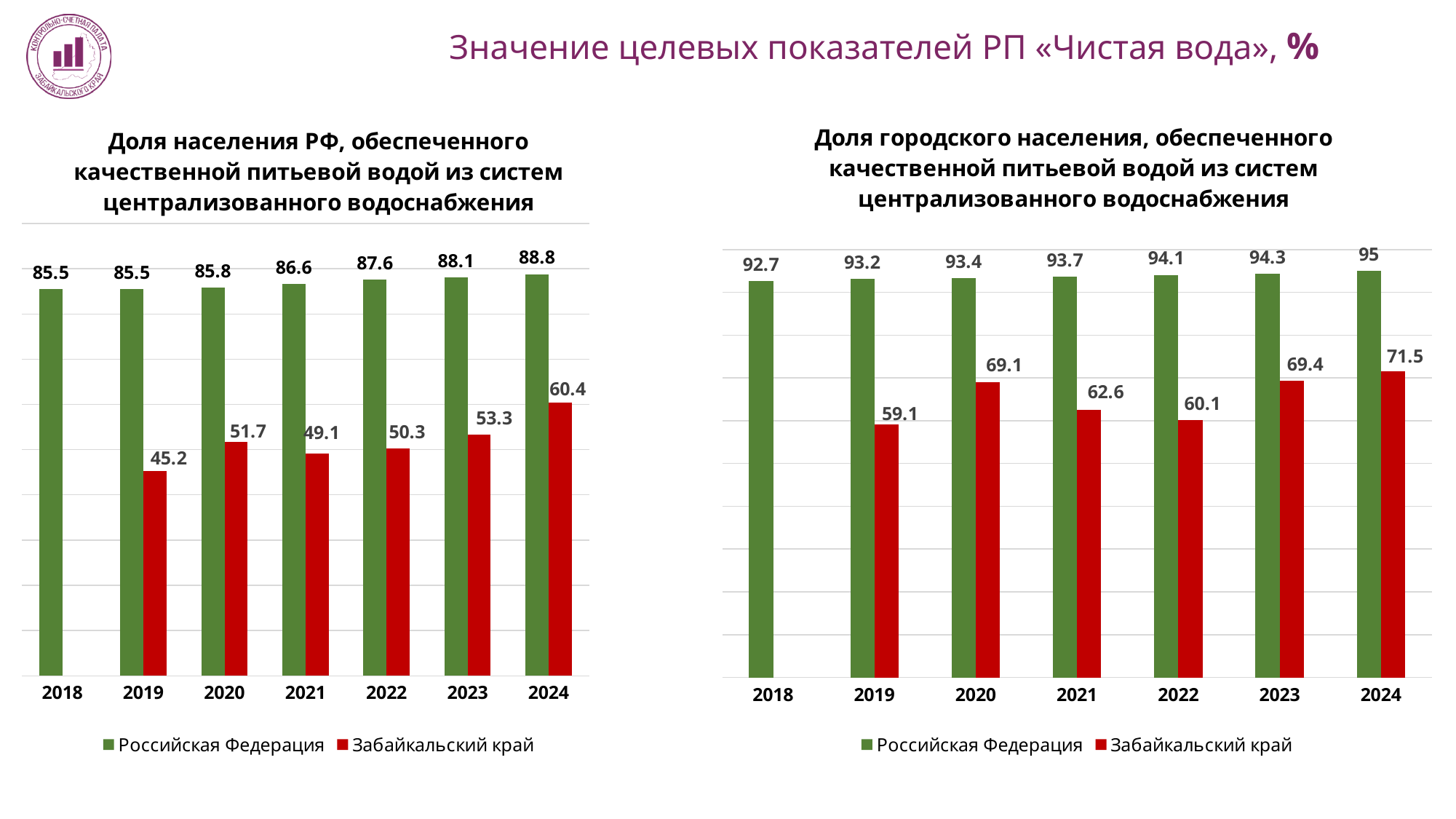
What type of chart is the left chart? bar chart In the left chart, what is the value for Российская Федерация in 2024? 88.8 How many years are shown on the x axis of the left chart? 7 In the right chart, which is larger: the Забайкальский край value in 2021 or in 2022? 2021 In the right chart, what is the value for Забайкальский край in 2020? 69.1 In the left chart, what is the difference between the Российская Федерация and Забайкальский край values in 2024? 28.4 In the right chart, does the Российская Федерация value rise or fall from 2018 to 2024? rise In the right chart, what is the value for Российская Федерация in 2018? 92.7 In the left chart, what is the value for Забайкальский край in 2019? 45.2 In the right chart, which year has the highest value for Забайкальский край? 2024 In the left chart, which year has the lowest value for Забайкальский край? 2019 How many series does the legend of the right chart list? 2